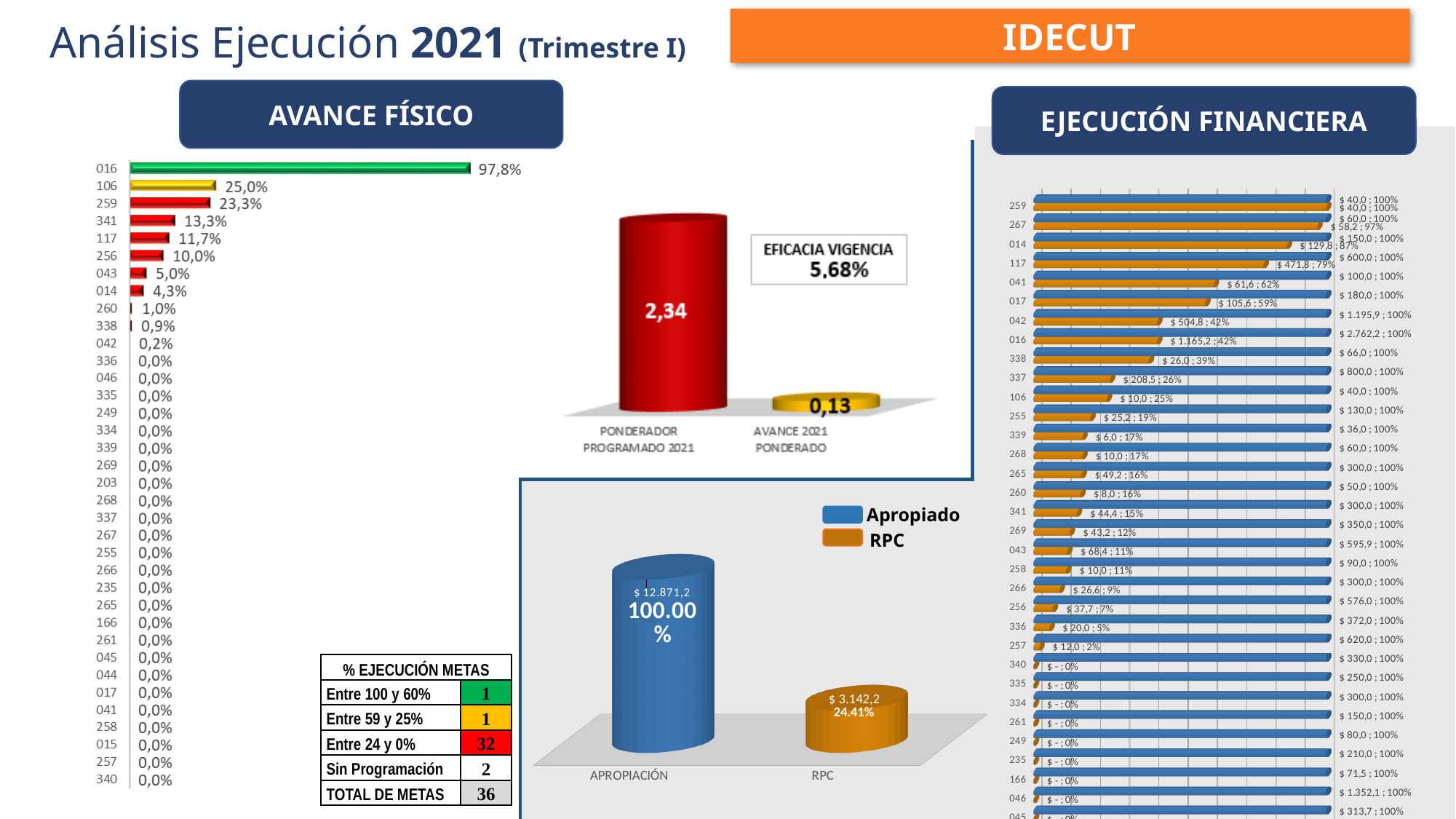
In the EJECUCIÓN FINANCIERA chart, what is the RPC value for category 117? $ 471,8 In the AVANCE FÍSICO bar chart, which category has the highest value? 016 In the AVANCE FÍSICO bar chart, which is larger, the value for 341 or the value for 117? 341 In the EFICACIA VIGENCIA chart, what is the difference between PONDERADOR PROGRAMADO 2021 and AVANCE 2021 PONDERADO? 2,21 In the chart at the bottom centre with APROPIACIÓN and RPC, what is the value labelled on the RPC bar? $ 3.142,2 In the chart at the bottom centre with APROPIACIÓN and RPC, how many series does the legend list? 2 In the AVANCE FÍSICO bar chart, how many categories are plotted? 36 In the AVANCE FÍSICO bar chart, what is the difference between the values for 106 and 259? 1,7% In the AVANCE FÍSICO bar chart, what is the value for category 016? 97,8% What kind of chart is the EJECUCIÓN FINANCIERA chart? Bar chart In the EJECUCIÓN FINANCIERA chart, what is the Apropiado value for category 016? $ 2.762,2 In the EFICACIA VIGENCIA chart, what is the value for PONDERADOR PROGRAMADO 2021? 2,34